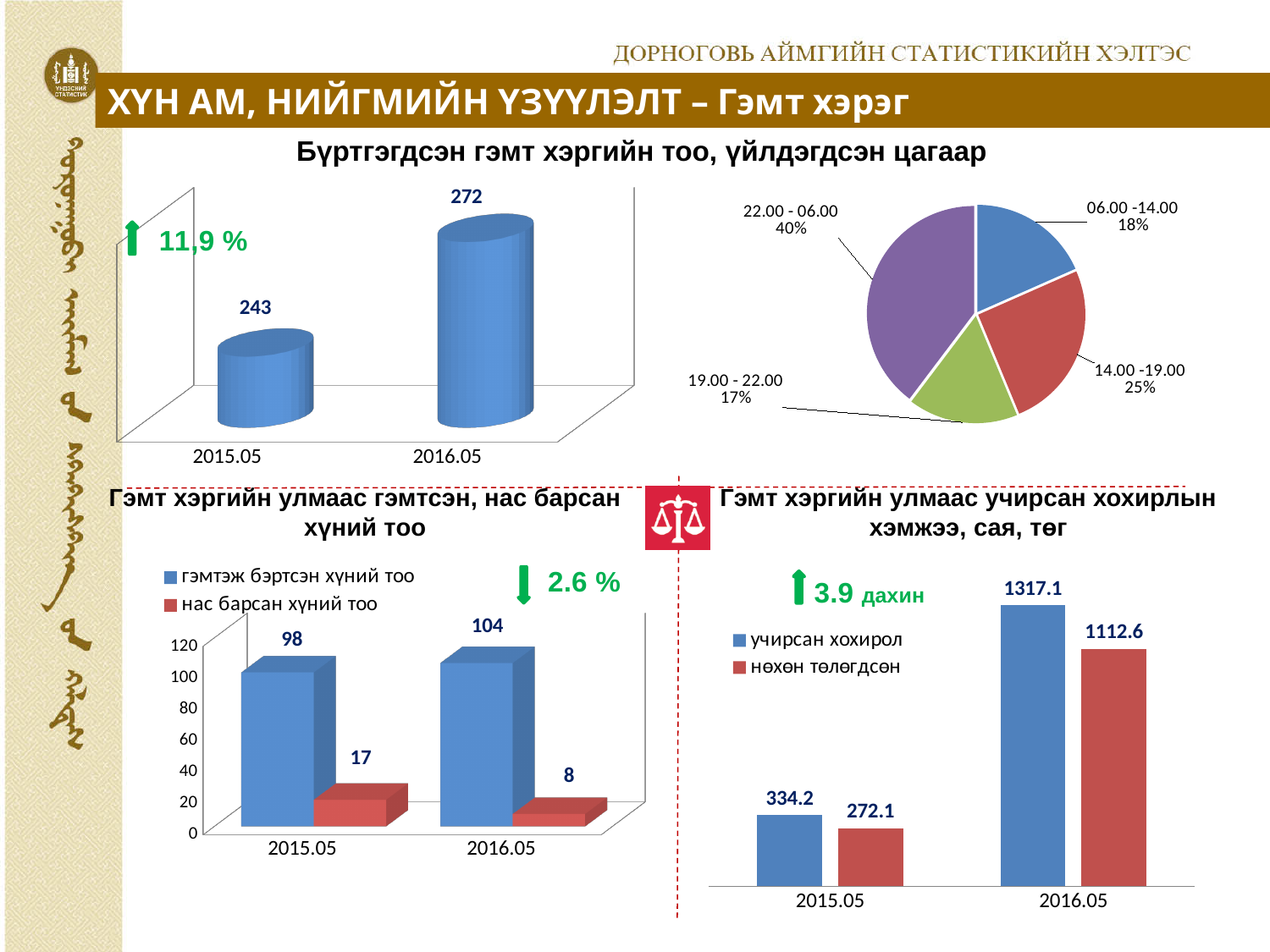
In the bottom-left chart, is the value of 'гэмтэж бэртсэн хүний тоо' for 2015.05 greater or less than 80? greater How many series does the legend of the bottom-left chart list? 2 What type of chart is the bottom-right chart? bar chart In the pie chart at the top right, what share does the 22.00 - 06.00 slice have? 40% In the bottom-left chart, what is the value of 'гэмтэж бэртсэн хүний тоо' for 2016.05? 104 How many slices does the pie chart at the top right have? 4 In the bottom-right chart, which is larger for 2015.05: 'учирсан хохирол' or 'нөхөн төлөгдсөн'? учирсан хохирол In the bottom-right chart, what is the value of 'учирсан хохирол' for 2016.05? 1317.1 In the top-left bar chart, what is the difference between the 2016.05 and 2015.05 values? 29 In the top-left bar chart, what is the value for 2016.05? 272 In the bottom-left chart, what is the value of 'нас барсан хүний тоо' for 2015.05? 17 In the pie chart at the top right, which time period has the smallest share? 19.00 - 22.00